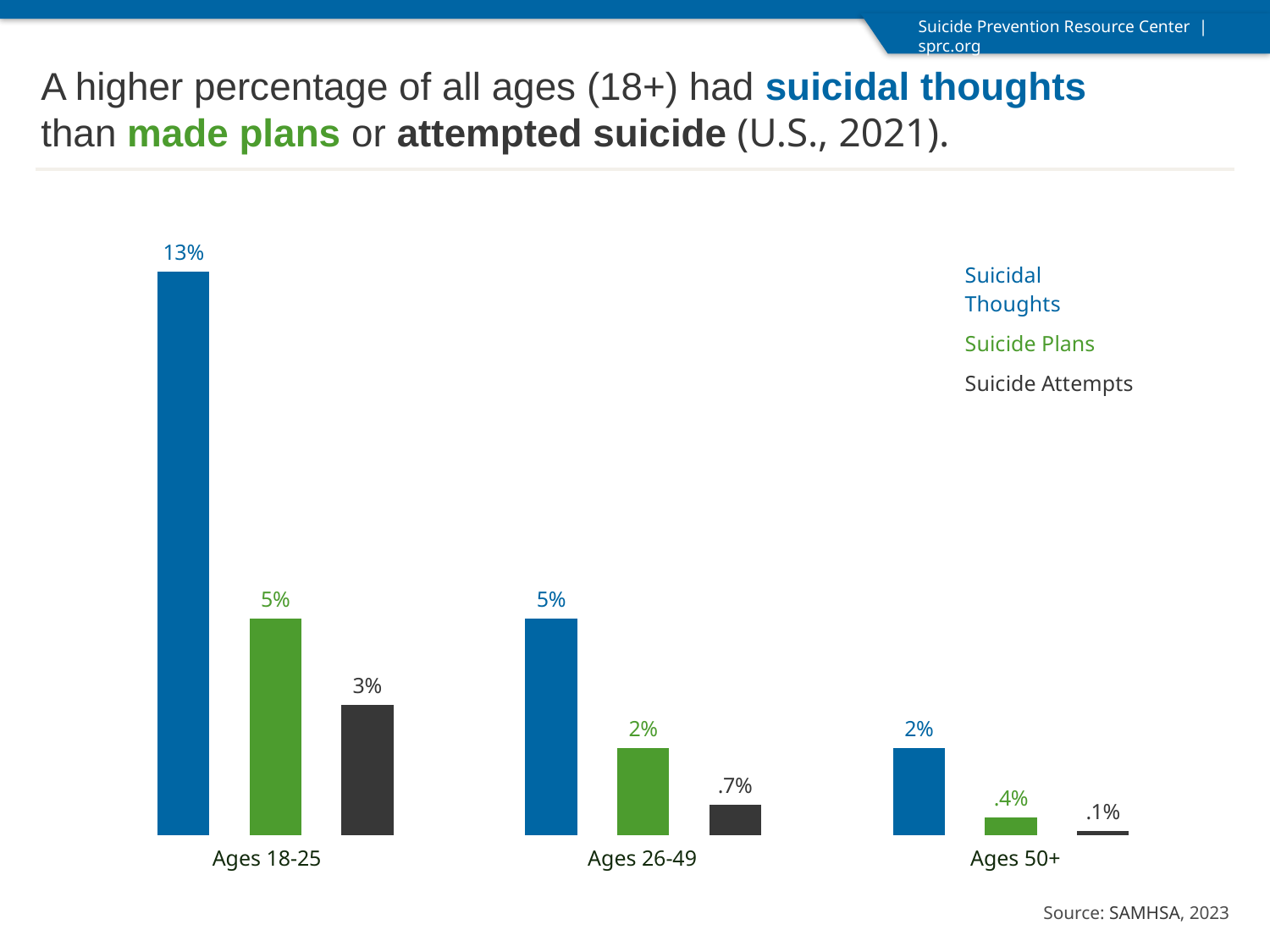
What is the value for Suicide Plans among Ages 50+? .4% How many age groups are shown on the chart? 3 What colour represents Suicide Plans in the chart? Green What kind of chart is shown on the slide? Bar chart Which age group has the lowest value for Suicide Attempts? Ages 50+ What is the difference between Suicidal Thoughts and Suicide Plans for Ages 18-25? 8% How many series does the legend list? 3 What percentage of Ages 18-25 had suicidal thoughts? 13% What is the value for Suicide Attempts among Ages 26-49? .7% Which age group has the highest value for Suicidal Thoughts? Ages 18-25 Do the Suicidal Thoughts values rise or fall as age group increases along the x axis? Fall Which is larger: Suicide Plans for Ages 18-25 or Suicidal Thoughts for Ages 50+? Suicide Plans for Ages 18-25